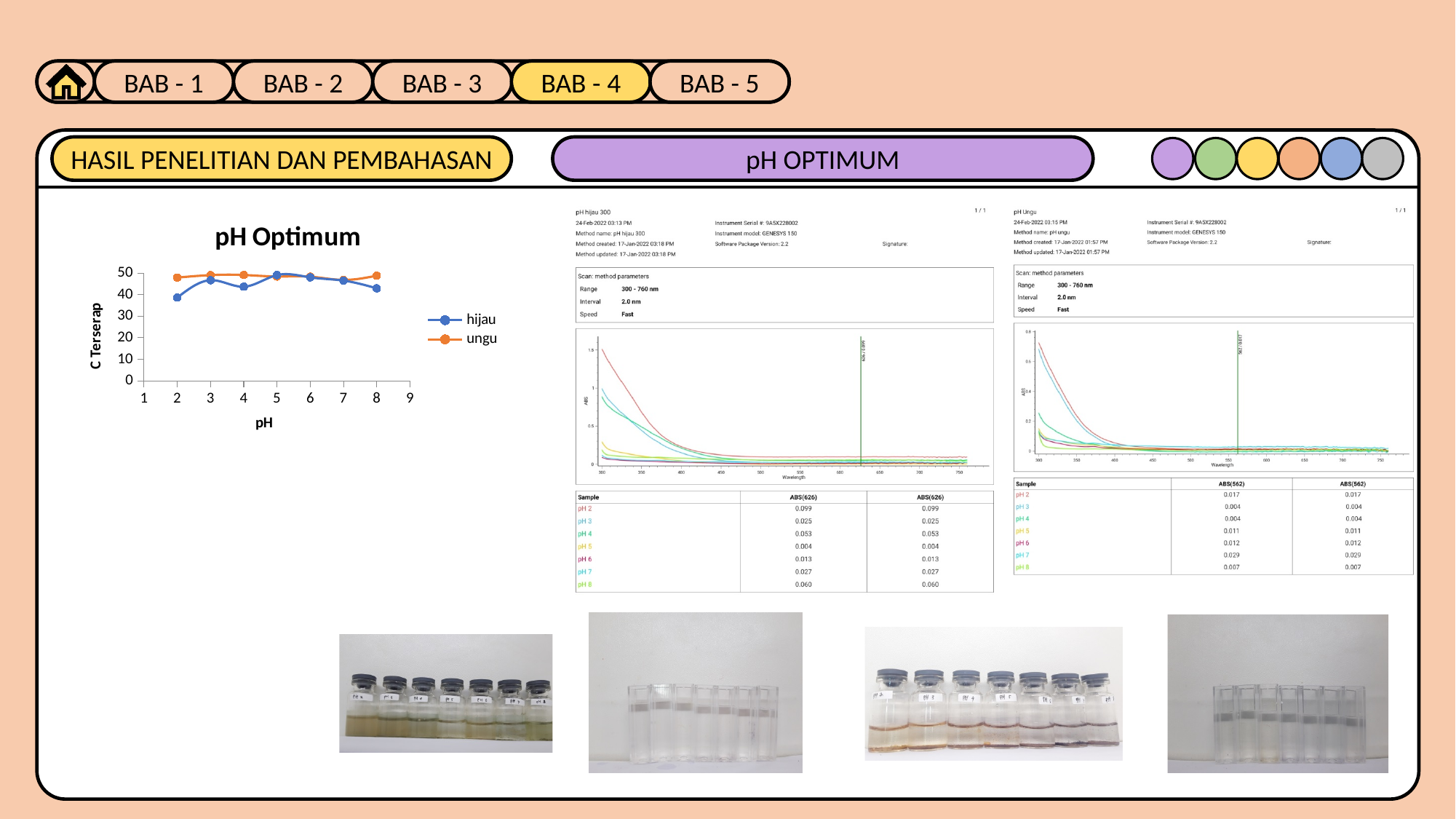
What are the two series named in the legend of the "pH Optimum" chart? hijau and ungu In the "pH Optimum" chart, which series has the larger value at pH 8, hijau or ungu? ungu What is the label of the y axis in the "pH Optimum" chart? C Terserap In the "pH Optimum" chart, does the hijau series rise or fall from pH 2 to pH 3? rise What kind of chart is the "pH Optimum" chart? line chart In the "pH Optimum" chart, at which pH is the hijau series lowest? pH 2 How many series does the legend of the "pH Optimum" chart list? 2 In the "pH Optimum" chart, is the hijau value at pH 8 greater or less than 40? greater In the "pH Optimum" chart, which series has the larger value at pH 2, hijau or ungu? ungu How many pH points are plotted for the hijau series in the "pH Optimum" chart? 7 In the "pH Optimum" chart, is the hijau value at pH 2 greater or less than 40? less In the "pH Optimum" chart, is the ungu value at pH 3 greater or less than 40? greater